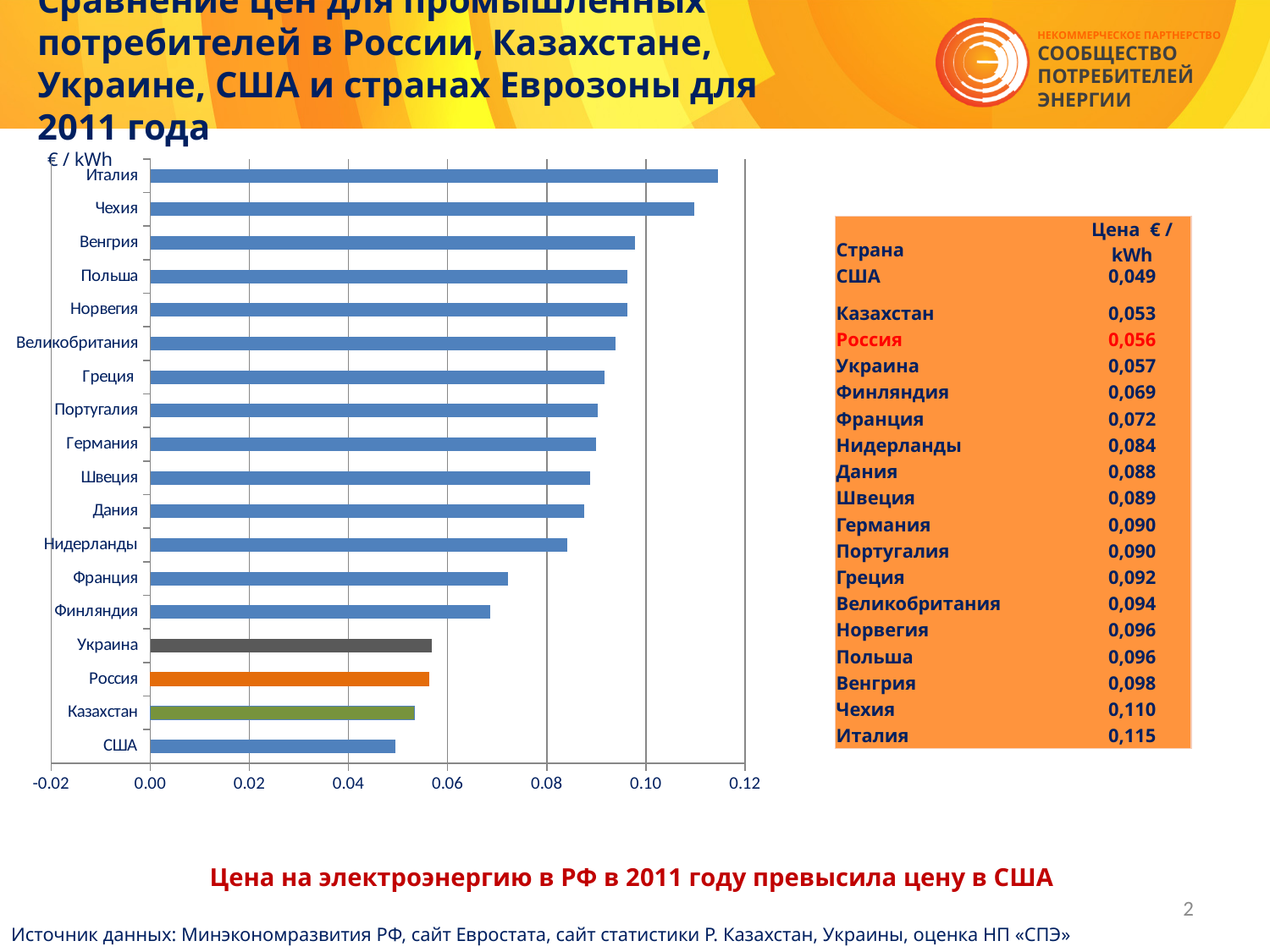
What is the difference in price between Италия and США? 0,066 What is the difference in price between Россия and США? 0,007 What unit is shown on the chart's axis label? € / kWh What is the price (€ / kWh) for Казахстан according to the slide? 0,053 Which country has the highest price in the chart? Италия How many countries are plotted in the bar chart? 18 What kind of chart is shown on the slide? bar chart What is the price (€ / kWh) for Италия according to the slide? 0,115 What is the price (€ / kWh) for Россия according to the slide? 0,056 Which country has the lowest price in the chart? США Is the value for Украина greater or less than 0.06? less Which has the higher price, Чехия or Венгрия? Чехия